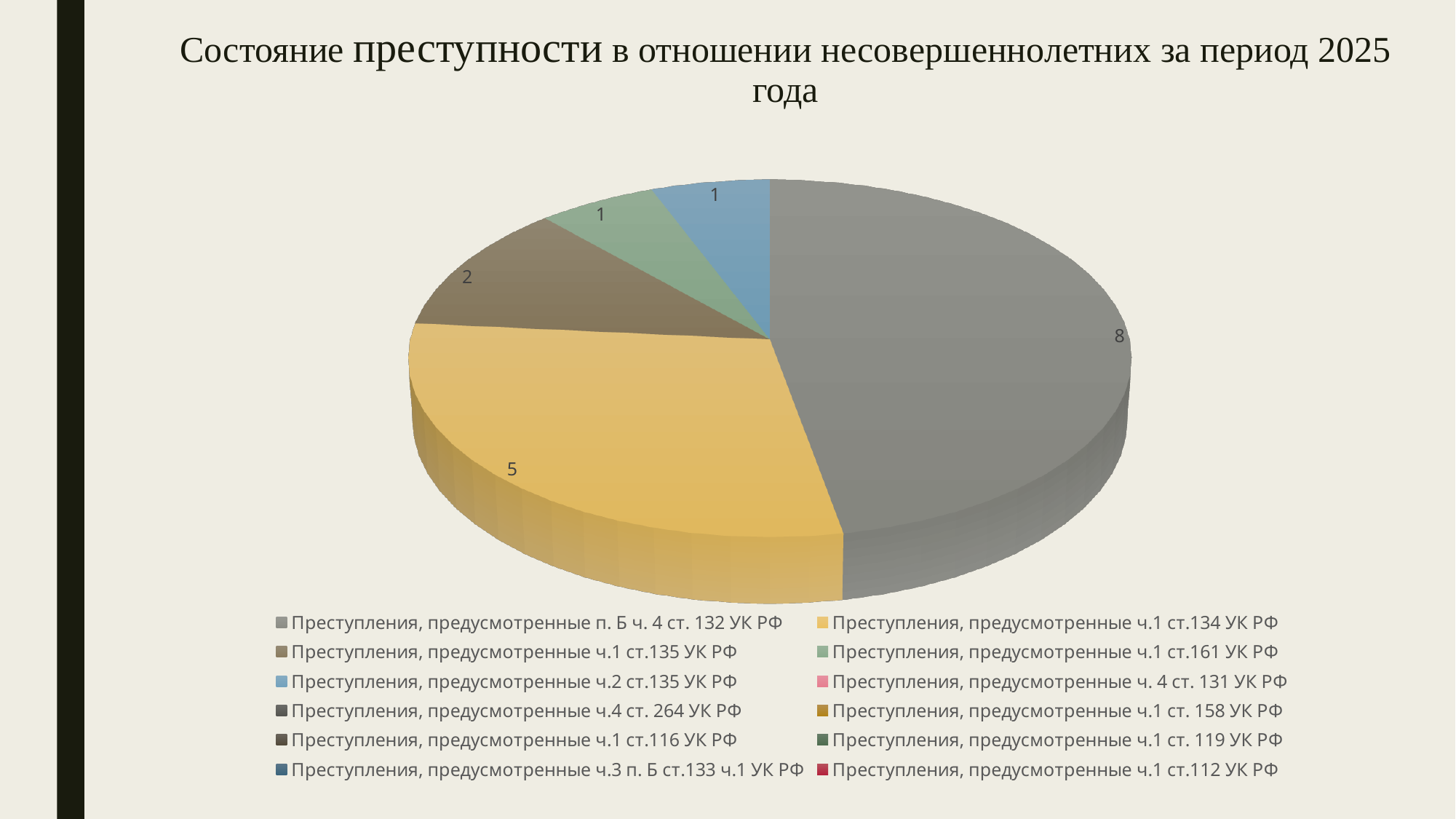
What is the value for Преступления, предусмотренные ч.1 ст.134 УК РФ? 5 Which is larger: the value for ч.1 ст.134 УК РФ or the value for ч.1 ст.135 УК РФ? ч.1 ст.134 УК РФ How many slices with data labels are visible in the pie? 5 What is the difference between the values for п. Б ч. 4 ст. 132 УК РФ and ч.1 ст.134 УК РФ? 3 What is the value for Преступления, предусмотренные ч.1 ст.135 УК РФ? 2 What is the value for Преступления, предусмотренные п. Б ч. 4 ст. 132 УК РФ? 8 What kind of chart is shown on the slide? pie chart What is the value for Преступления, предусмотренные ч.2 ст.135 УК РФ? 1 How many entries does the legend list? 12 What is the title of the chart? Состояние преступности в отношении несовершеннолетних за период 2025 года Which category has the largest slice of the pie? Преступления, предусмотренные п. Б ч. 4 ст. 132 УК РФ What is the value for Преступления, предусмотренные ч.1 ст.161 УК РФ? 1